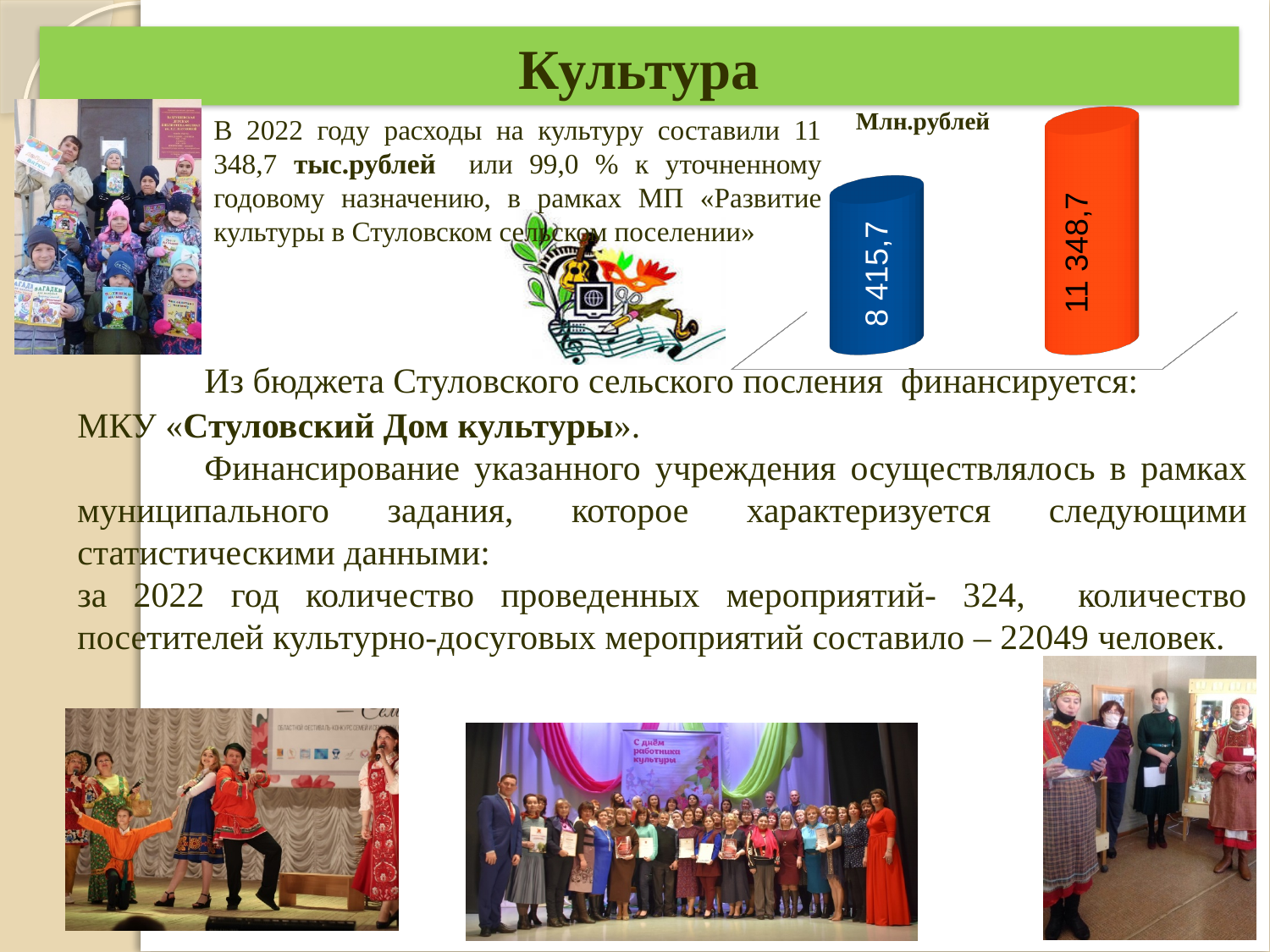
How many bars does the chart contain? 2 Which bar in the chart shows the lower value, the blue one or the orange one? the blue one What value is printed on the blue bar of the chart? 8 415,7 Is the value on the right-hand bar of the chart larger or smaller than the value on the left-hand bar? larger What unit label is printed above the chart? Млн.рублей What is the difference between the values on the orange bar and the blue bar in the chart? 2 933,0 What kind of chart is shown on the slide? bar chart Do the values in the chart rise or fall from left to right? rise What value is printed on the orange bar of the chart? 11 348,7 What colour is the bar with the value 11 348,7 in the chart? orange Which bar in the chart shows the higher value, the blue one or the orange one? the orange one